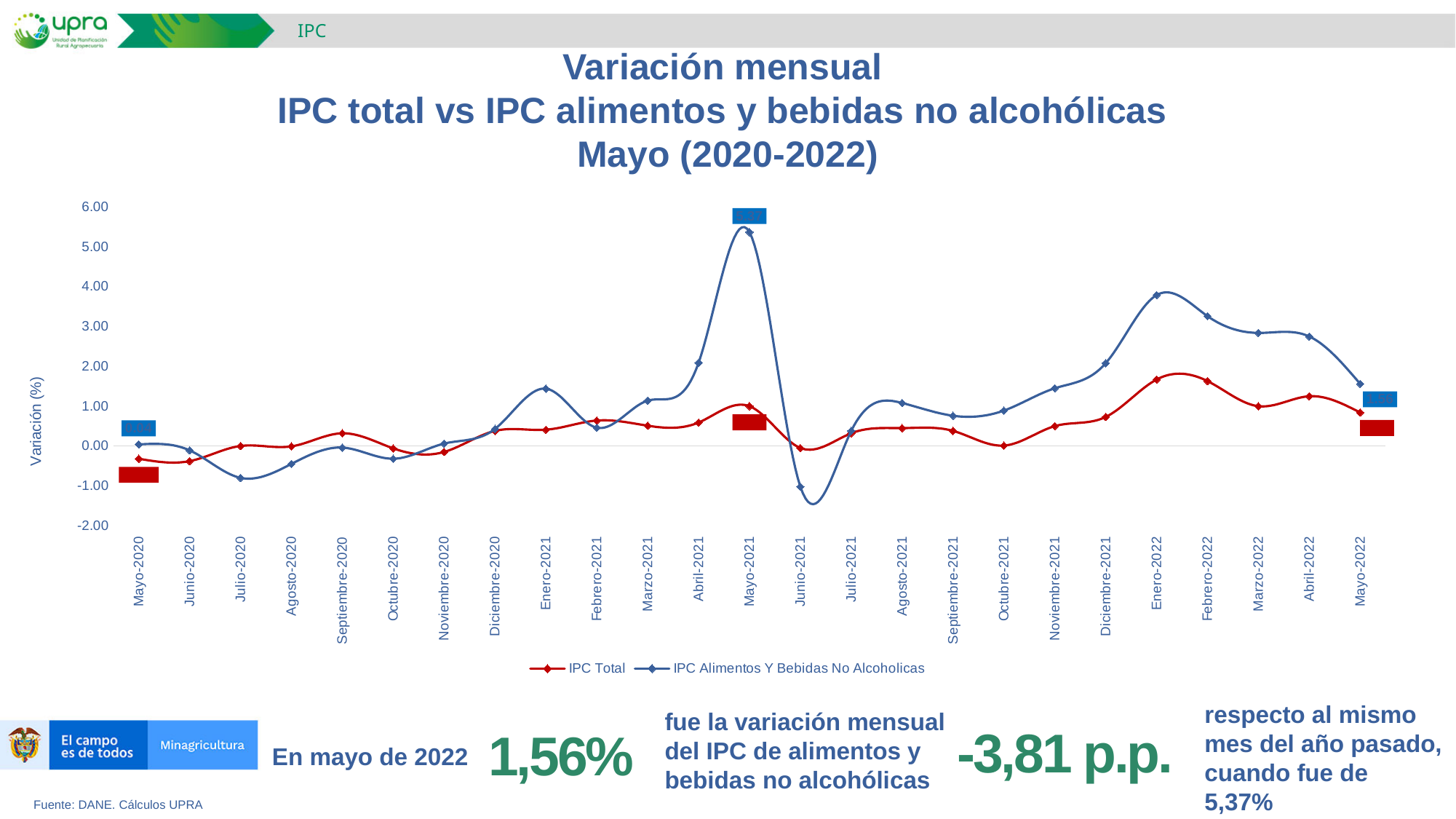
Is the value for IPC Alimentos Y Bebidas No Alcoholicas in Enero-2022 greater or less than 3.00? greater In Mayo-2021, which series has the larger value, IPC Total or IPC Alimentos Y Bebidas No Alcoholicas? IPC Alimentos Y Bebidas No Alcoholicas In which month does the IPC Alimentos Y Bebidas No Alcoholicas series reach its highest value? Mayo-2021 In which month does the IPC Alimentos Y Bebidas No Alcoholicas series reach its lowest value? Junio-2021 What kind of chart is shown on the slide? line chart Does the IPC Alimentos Y Bebidas No Alcoholicas series rise or fall from Enero-2022 to Mayo-2022? fall How many months are plotted along the x axis? 25 By how many percentage points did the May 2022 variation of the IPC de alimentos y bebidas no alcohólicas differ from May 2021, as stated on the slide? -3,81 p.p. How many series does the legend list? 2 What was the monthly variation of the IPC de alimentos y bebidas no alcohólicas in May 2021, as stated on the slide? 5,37% What was the monthly variation of the IPC de alimentos y bebidas no alcohólicas in May 2022, as stated on the slide? 1,56%